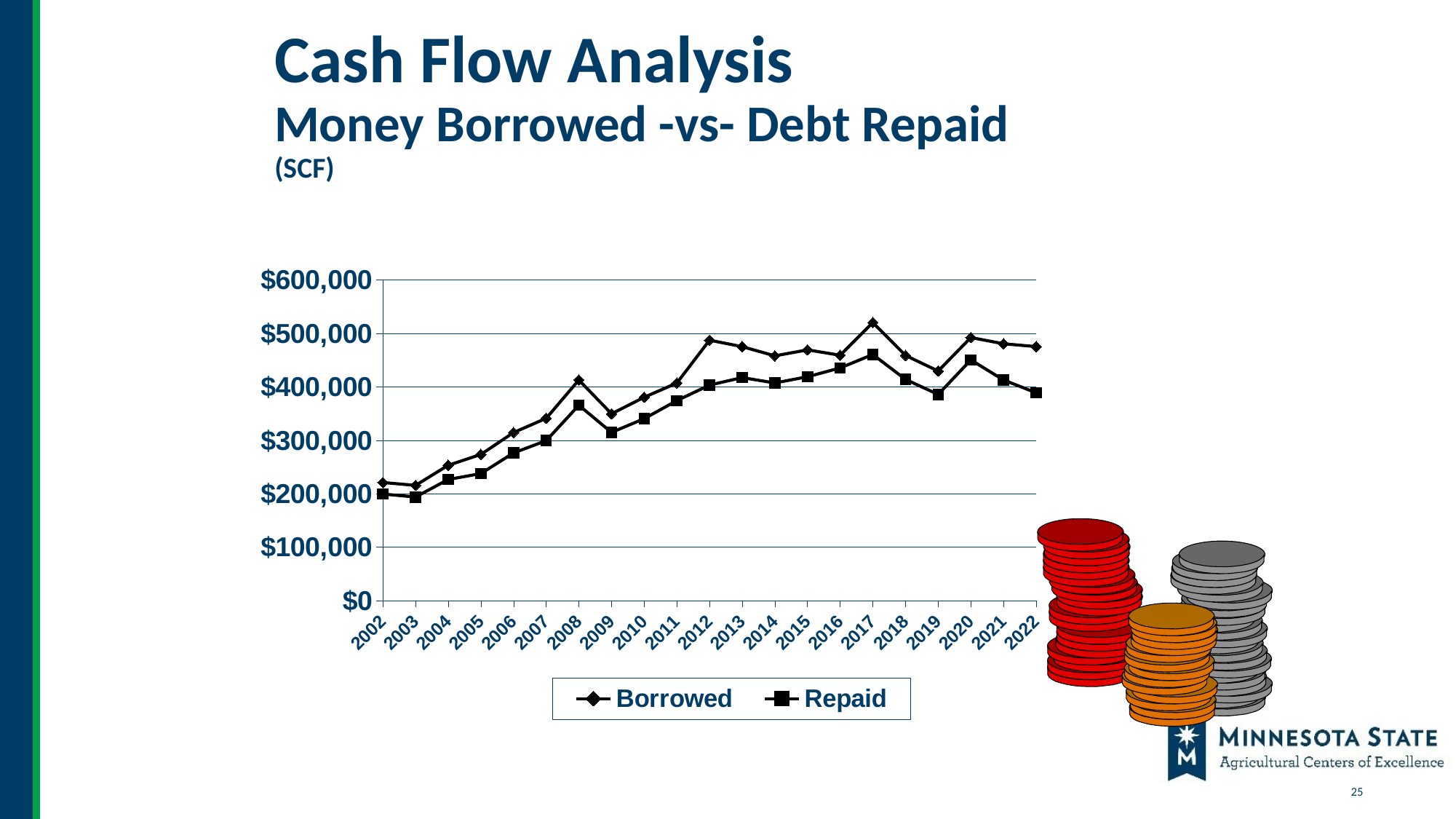
In 2008, which is larger, the Borrowed value or the Repaid value? Borrowed Does the Borrowed series rise or fall from 2002 to 2008? Rise Is the Repaid value for 2022 greater or less than $400,000? less Is the Borrowed value for 2017 greater or less than $500,000? greater How many years are plotted along the x axis? 21 What kind of chart is shown on the slide? Line chart In which year does the Borrowed series reach its highest value? 2017 Is the Borrowed value for 2008 greater or less than $400,000? greater Which series are listed in the legend? Borrowed and Repaid How many series does the legend list? 2 Which is larger, the Borrowed value for 2017 or the Borrowed value for 2009? 2017